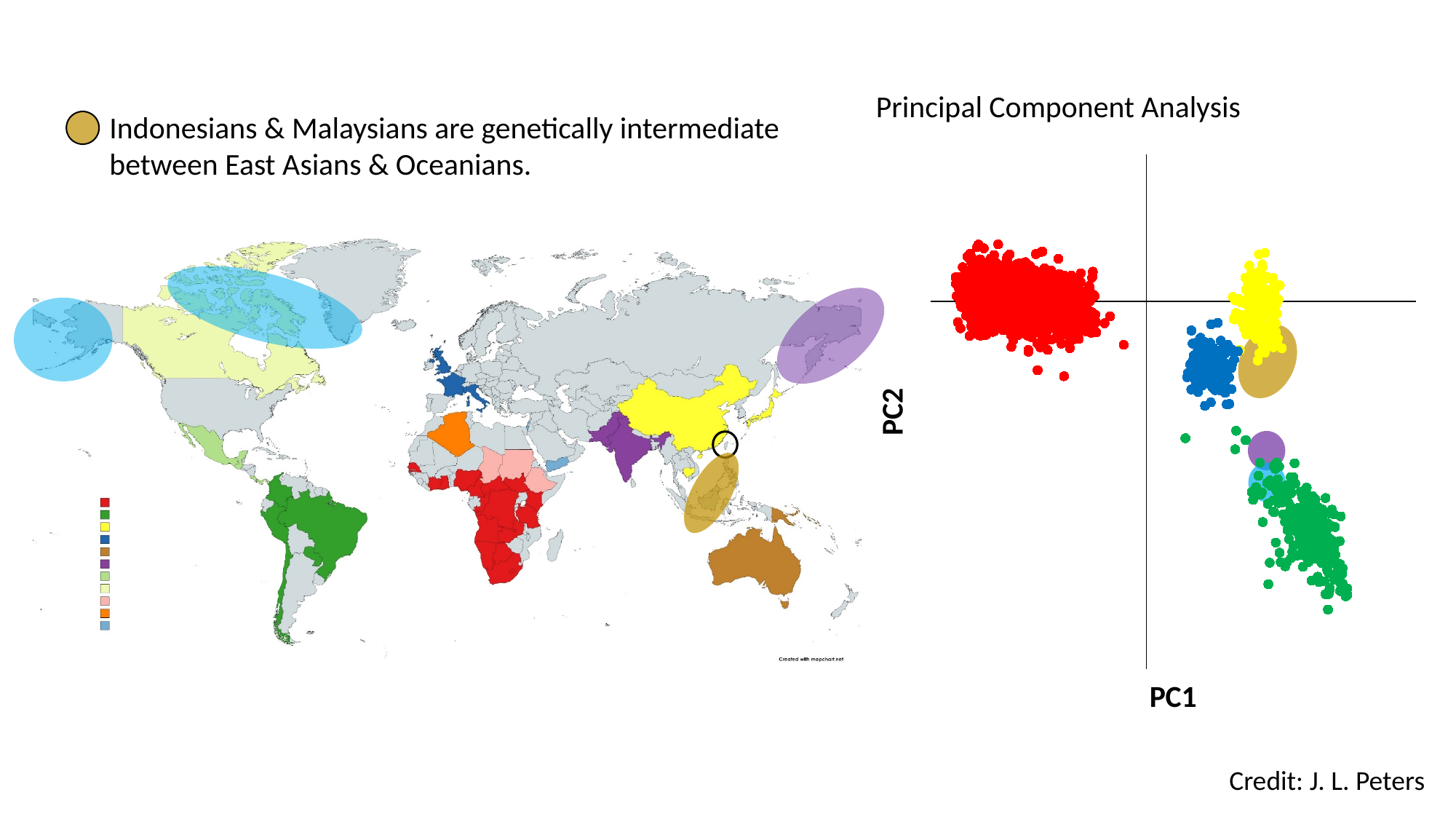
In the Principal Component Analysis chart, is the green cluster above or below the horizontal PC1 axis line? below In the Principal Component Analysis chart, which colour cluster lies furthest to the left along PC1? red What kind of chart is the Principal Component Analysis plot on the right of the slide? scatter plot In the Principal Component Analysis chart, which colour cluster extends lowest along PC2? green In the Principal Component Analysis chart, which cluster is further to the left along PC1, the red cluster or the green cluster? red According to the slide text, which population is genetically intermediate between East Asians and Oceanians? Indonesians & Malaysians In the Principal Component Analysis chart, is the red cluster to the left or to the right of the vertical PC2 axis line? left What is the title of the chart on the right of the slide? Principal Component Analysis In the Principal Component Analysis chart, what are the labels of the horizontal and vertical axes? PC1 and PC2